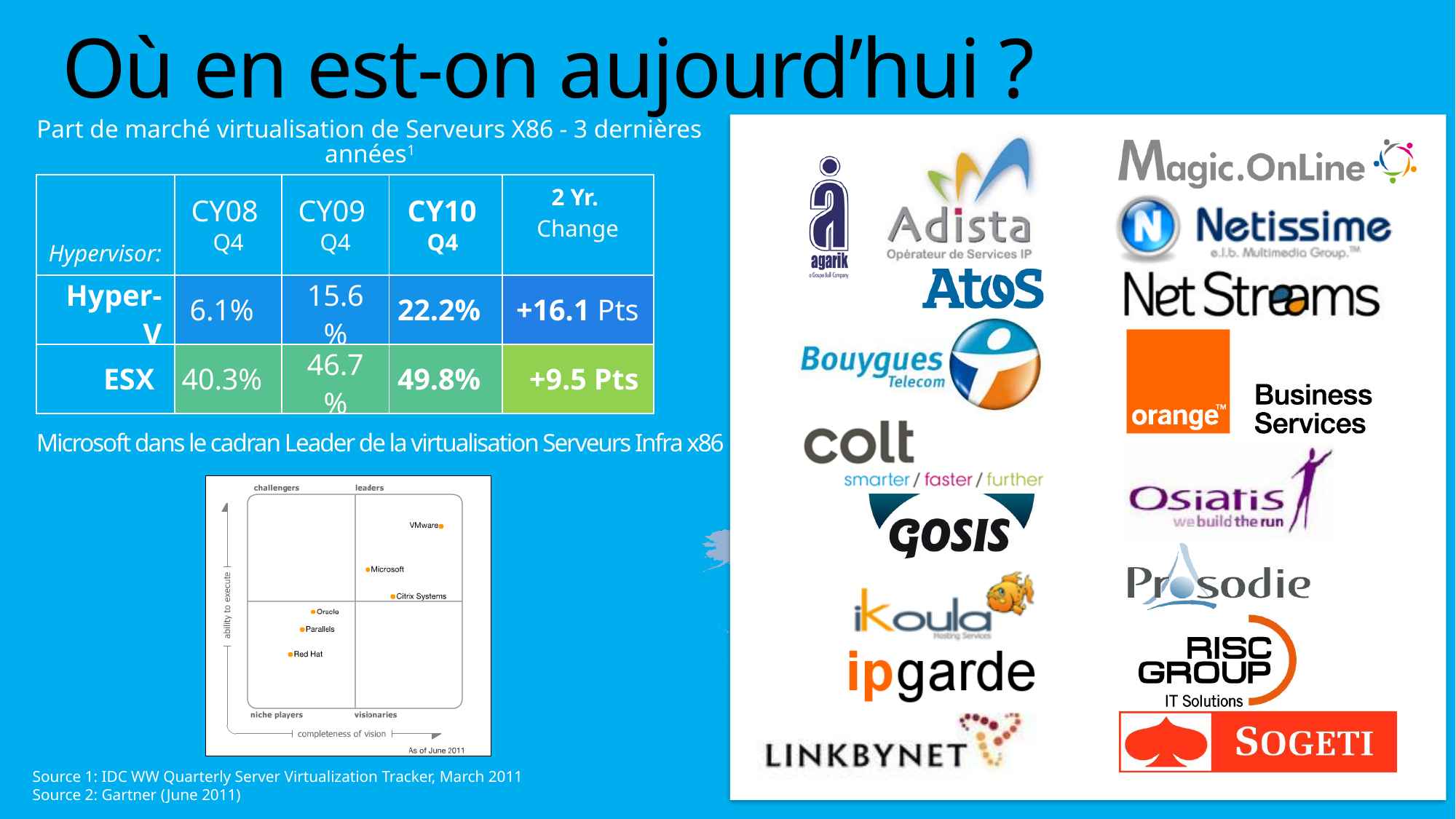
In the Magic Quadrant chart, which quadrant is Microsoft plotted in? leaders In the Magic Quadrant chart, how many vendors are plotted? 6 In the Magic Quadrant chart, how many vendors are in the leaders quadrant? 3 What kind of chart is the Gartner Magic Quadrant shown at the bottom left of the slide? scatter (quadrant) chart In the Magic Quadrant chart, which vendor is furthest right on completeness of vision? VMware In the Magic Quadrant chart, which vendor is lowest on ability to execute? Red Hat In the market share table, what is the Hyper-V share for CY10 Q4? 22.2% In the Magic Quadrant chart, what date is the chart stated to be as of? As of June 2011 In the Magic Quadrant chart, which has the higher ability to execute, Microsoft or Citrix Systems? Microsoft In the Magic Quadrant chart, which vendor is highest on ability to execute? VMware In the Magic Quadrant chart, which quadrant is Oracle plotted in? niche players In the Magic Quadrant chart, what is the label of the vertical axis? ability to execute